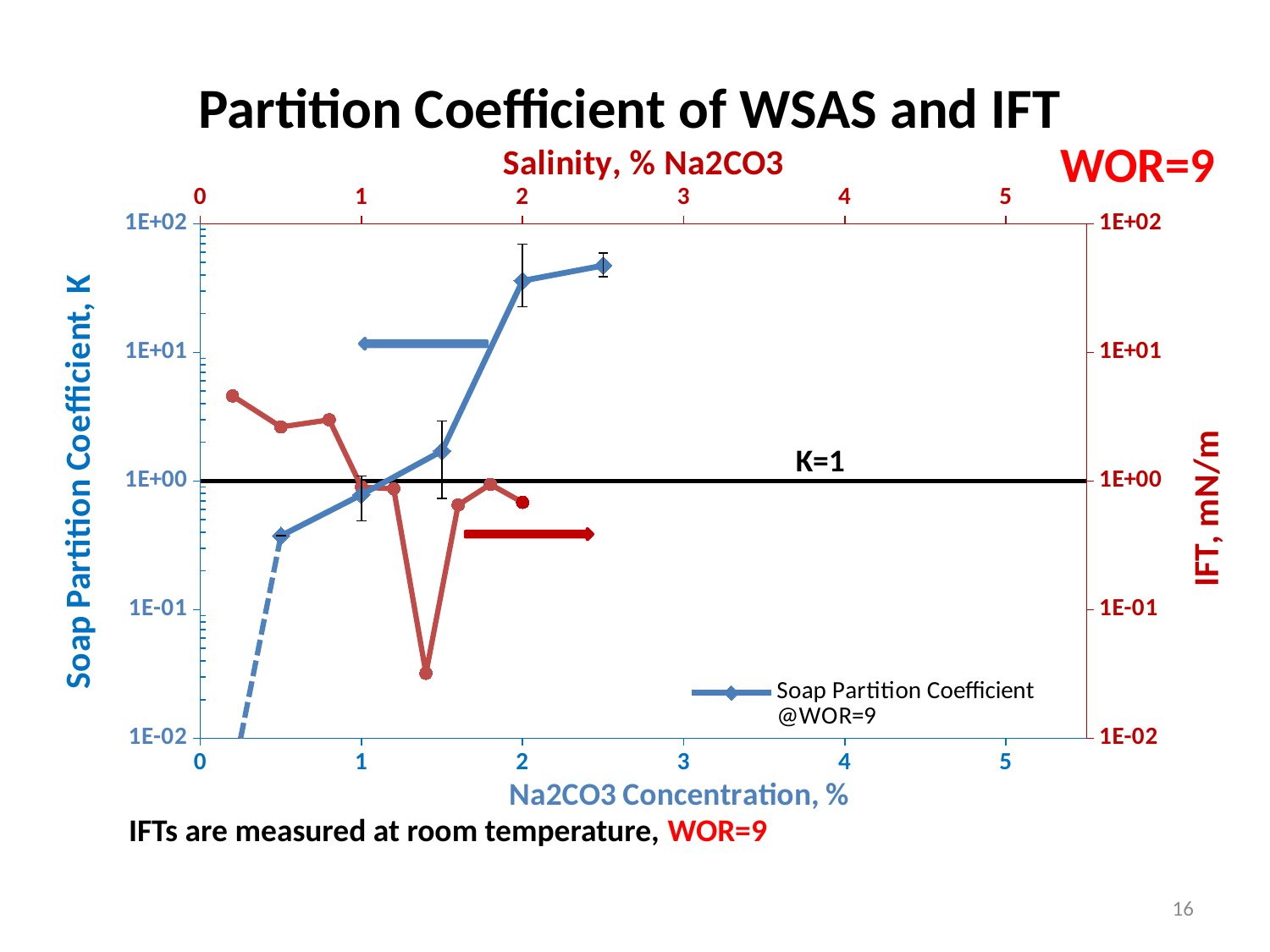
What is the title of the chart? Partition Coefficient of WSAS and IFT What series does the legend list? Soap Partition Coefficient @WOR=9 At which Na2CO3 concentration is the Soap Partition Coefficient highest? 2.5 Which is larger: the Soap Partition Coefficient at 2% Na2CO3 or at 1% Na2CO3? 2% Na2CO3 What kind of chart is shown on the slide? line chart How many data points are plotted for the Soap Partition Coefficient series? 5 Is the IFT at the lowest salinity plotted (about 0.2% Na2CO3) greater or less than 1E+00? greater Is the Soap Partition Coefficient at 2.5% Na2CO3 greater or less than 1E+01? greater Does the Soap Partition Coefficient rise or fall as Na2CO3 concentration increases? rise Is the Soap Partition Coefficient at 0.5% Na2CO3 greater or less than 1E+00? less What value does the horizontal black reference line mark on the chart? K=1